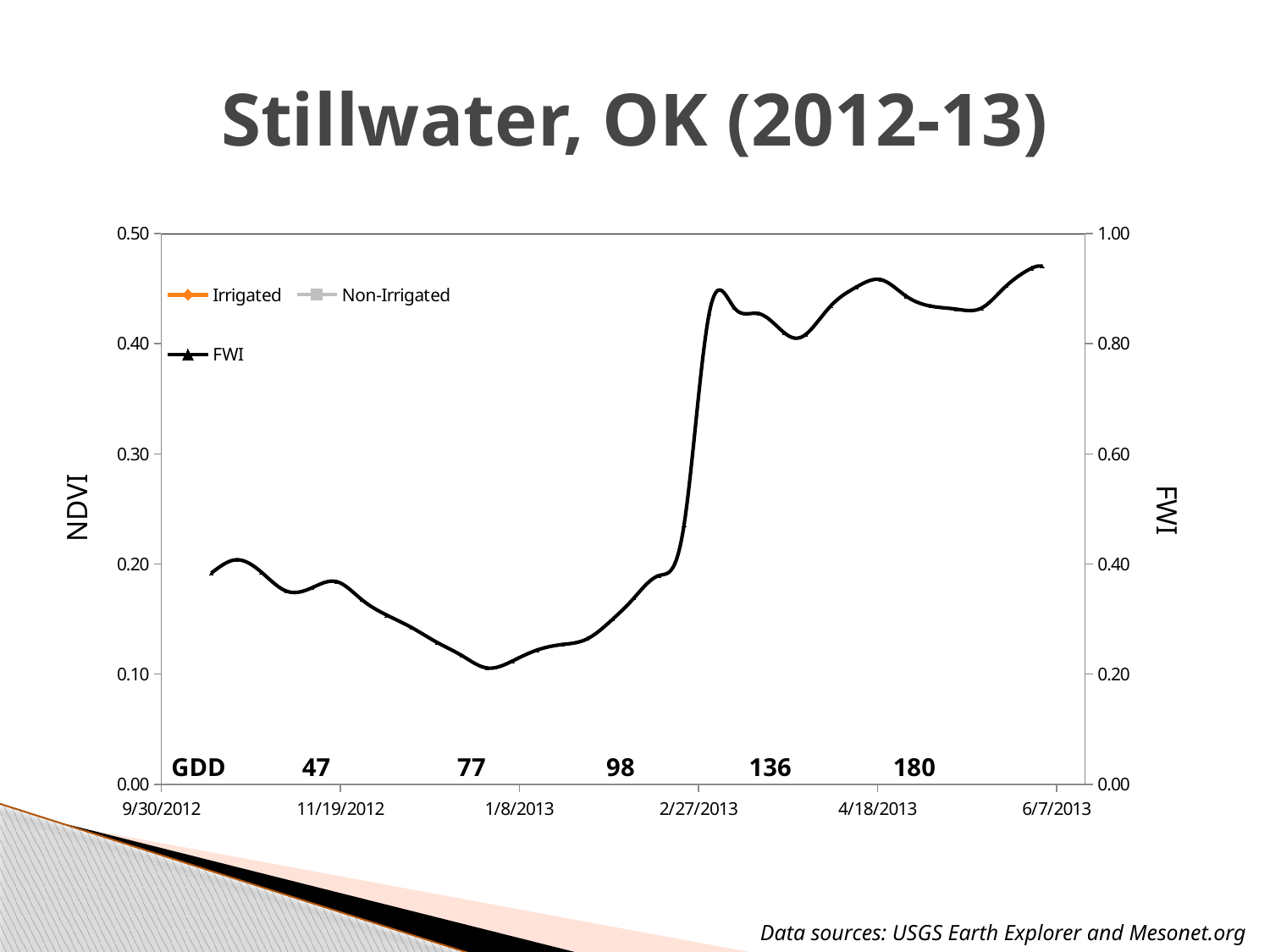
How many numeric GDD values are printed along the bottom of the chart? 5 What is the largest GDD value printed along the bottom of the chart? 180 How many series does the legend list? 3 What is the label of the right-hand vertical axis? FWI Near which x-axis date does the FWI line reach its lowest point? 1/8/2013 Is the FWI value near 1/8/2013 greater or less than 0.40 on the FWI axis? less Is the FWI value near 11/19/2012 greater or less than 0.60 on the FWI axis? less Does the FWI line rise or fall between 1/8/2013 and 6/7/2013? rise What is the title of the chart on the slide? Stillwater, OK (2012-13) What kind of chart is shown on the slide? line chart Does the FWI line rise or fall between 9/30/2012 and 1/8/2013? fall Is the FWI value near 4/18/2013 greater or less than 0.80 on the FWI axis? greater